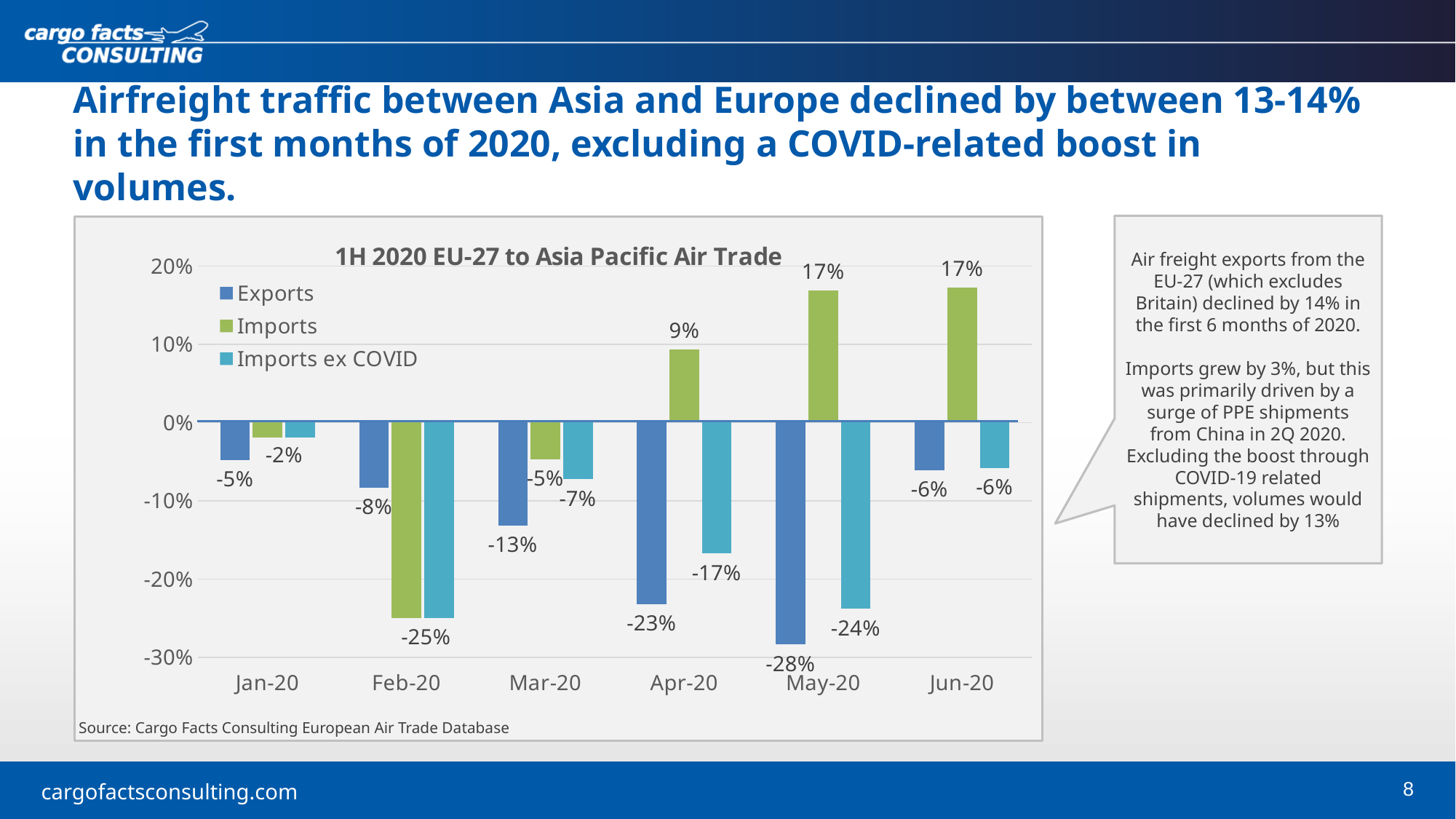
How many months are shown on the x axis? 6 For Mar-20, which is lower: Exports or Imports ex COVID? Exports From Jan-20 to May-20, do the Exports values rise or fall? Fall What is the Exports value for Mar-20? -13% What is the Imports ex COVID value for May-20? -24% What is the Exports value for Jan-20? -5% How many series does the legend list? 3 In which month is the Exports value lowest? May-20 Is the Exports value for Feb-20 greater or less than -10%? greater What is the difference between the Exports values for Apr-20 and May-20? 5 percentage points What kind of chart is shown on the slide? Bar chart What is the Imports value for Apr-20? 9%